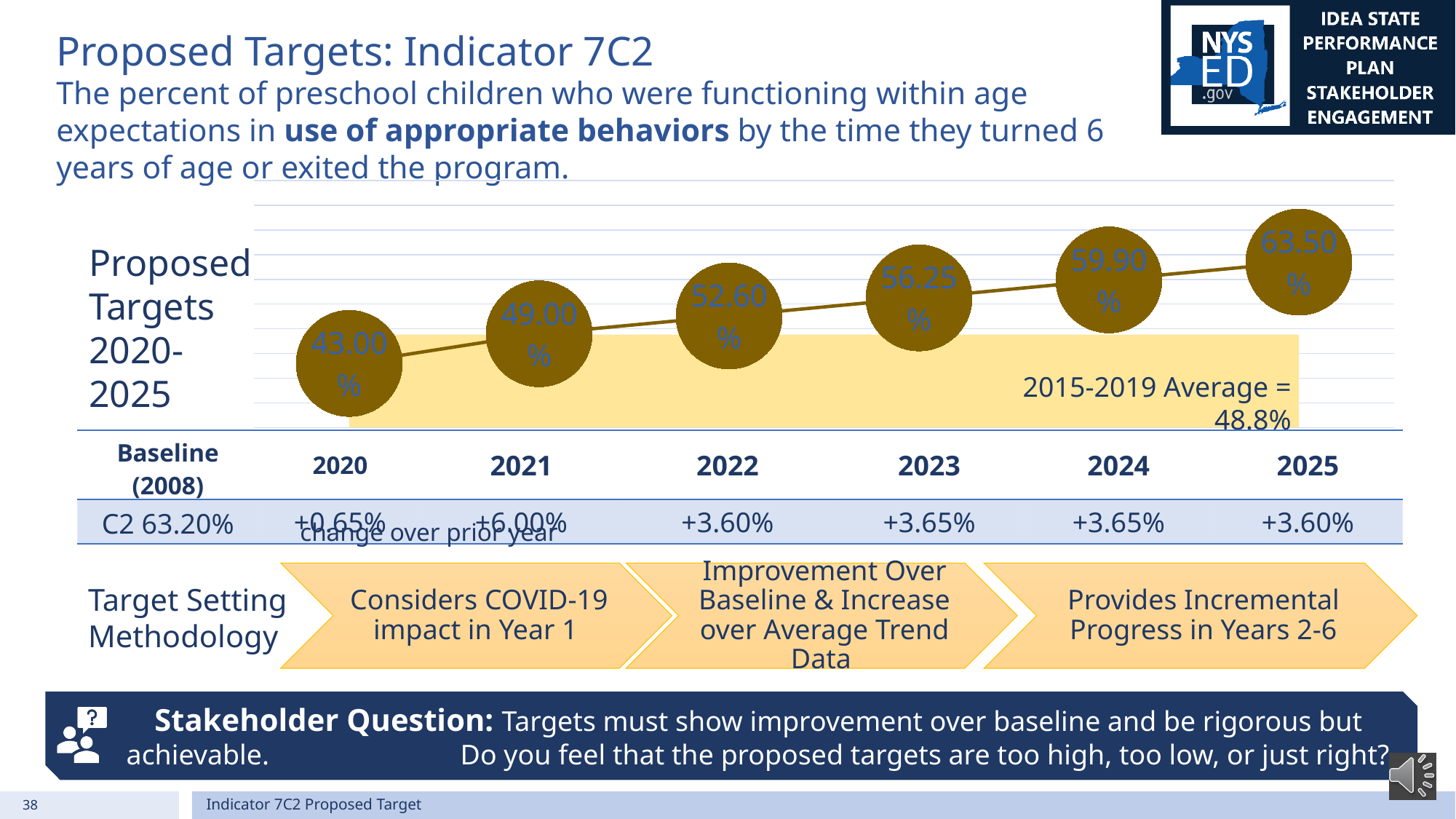
What is the 2015-2019 average shown on the chart? 48.8% What is the proposed target value for 2023? 56.25% Which year has the lowest proposed target? 2020 Which year has the highest proposed target? 2025 What is the difference between the proposed targets for 2025 and 2020? 20.50% What is the proposed target value for 2025? 63.50% How many years are plotted on the chart? 6 What is the proposed target value for 2020? 43.00% Which is larger, the proposed target for 2024 or for 2022? 2024 What is the difference between the proposed targets for 2022 and 2021? 3.60% What kind of chart is shown on the slide? combination area and line chart Do the proposed target values rise or fall from 2020 to 2025? rise